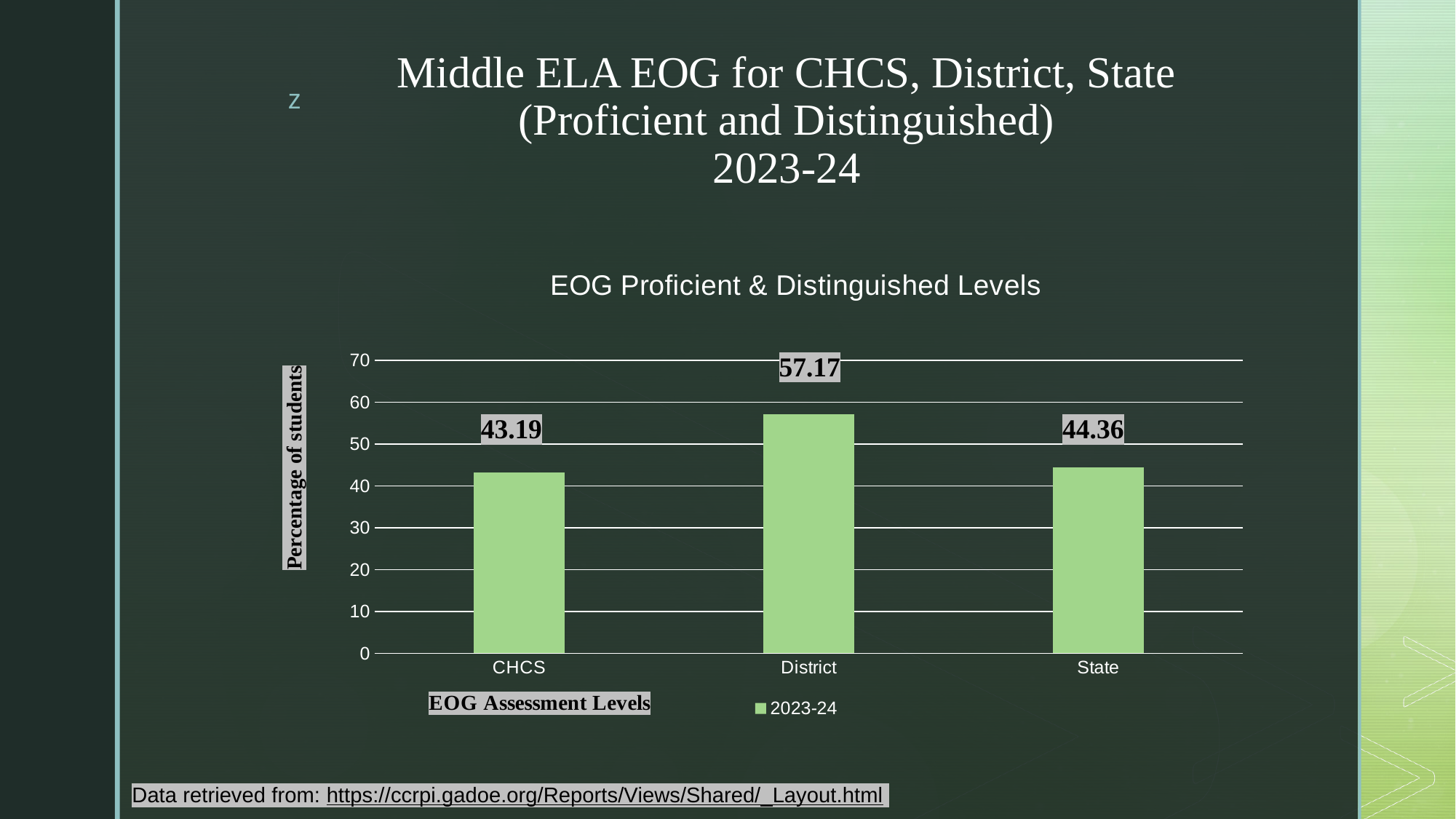
Is the value for District greater or less than 50? greater What is the value for State? 44.36 What is the value for CHCS? 43.19 Which is larger, the value for District or the value for State? District What is the difference between the District value and the CHCS value? 13.98 What kind of chart is shown? bar chart What is the difference between the State value and the CHCS value? 1.17 How many categories are shown on the x axis? 3 How many series does the legend list? 1 Which category has the highest value? District Which category has the lowest value? CHCS What is the value for District? 57.17